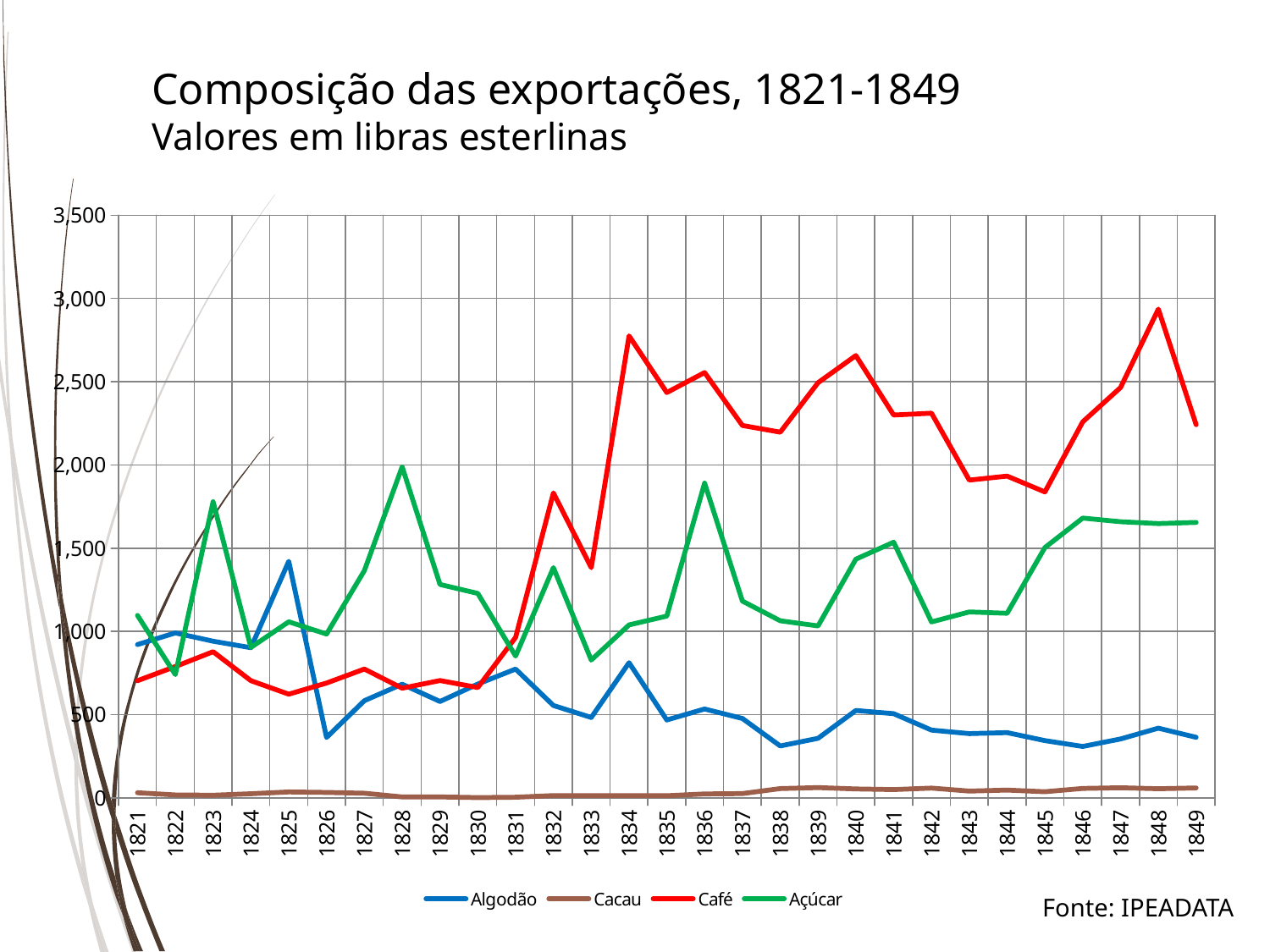
Is the value for Café in 1848 greater or less than 2,500? greater How many series does the legend list? 4 Does the value for Café rise or fall from 1830 to 1834? rise What kind of chart is shown on the slide? line chart Is the value for Algodão in 1826 greater or less than 500? less How many years are plotted along the x axis? 29 Is the value for Açúcar in 1828 greater or less than 1,500? greater In which year does Café reach its highest value? 1848 In 1825, which is larger, Algodão or Café? Algodão In 1849, which is larger, Café or Açúcar? Café Which series has the lowest value in 1840? Cacau What is the title of the chart? Composição das exportações, 1821-1849